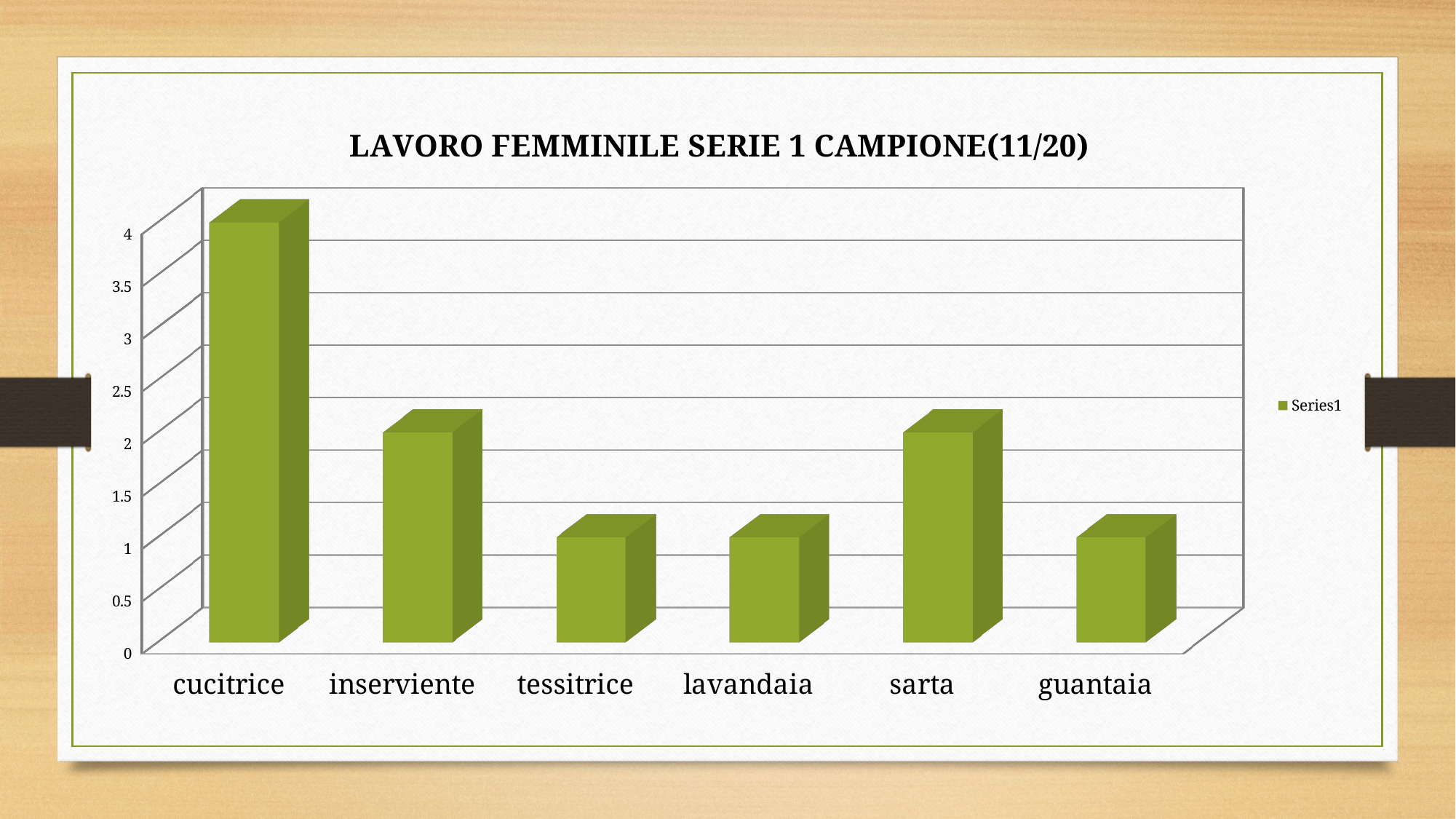
What is the title of the chart? LAVORO FEMMINILE SERIE 1 CAMPIONE(11/20) What is the difference between the value for cucitrice and the value for sarta? 2 Which category has the highest value? cucitrice How many categories are shown on the x axis of the chart? 6 What is the value for sarta? 2 Which is larger, the value for inserviente or the value for lavandaia? inserviente Is the value for cucitrice greater or less than 3? greater Is the value for tessitrice greater or less than 1.5? less What is the value for inserviente? 2 What is the value for cucitrice? 4 What kind of chart is shown on the slide? bar chart How many series does the legend list? 1